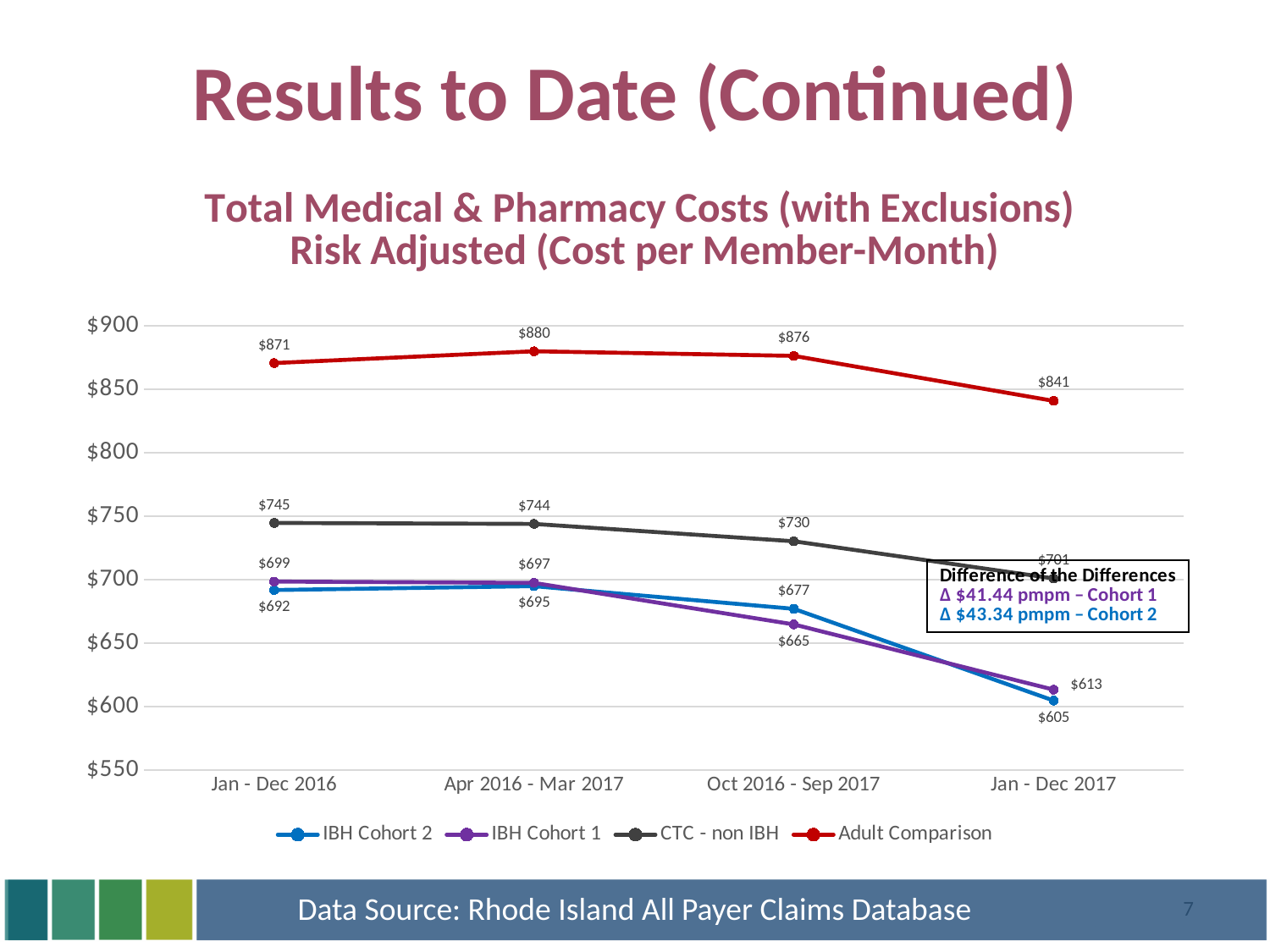
How many series does the legend list? 4 Does the CTC - non IBH series rise or fall from Jan - Dec 2016 to Jan - Dec 2017? Fall How many time periods are shown on the x axis? 4 In which period is the IBH Cohort 2 value lowest? Jan - Dec 2017 What is the value for Adult Comparison in Jan - Dec 2016? $871 What is the difference between Adult Comparison and CTC - non IBH in Jan - Dec 2017? $140 What is the value for CTC - non IBH in Oct 2016 - Sep 2017? $730 What kind of chart is shown on the slide? Line chart What is the value for IBH Cohort 1 in Jan - Dec 2017? $613 In which period is the Adult Comparison value highest? Apr 2016 - Mar 2017 By how much did the Adult Comparison value fall from Oct 2016 - Sep 2017 to Jan - Dec 2017? $35 Which is larger in Jan - Dec 2017, IBH Cohort 1 or IBH Cohort 2? IBH Cohort 1